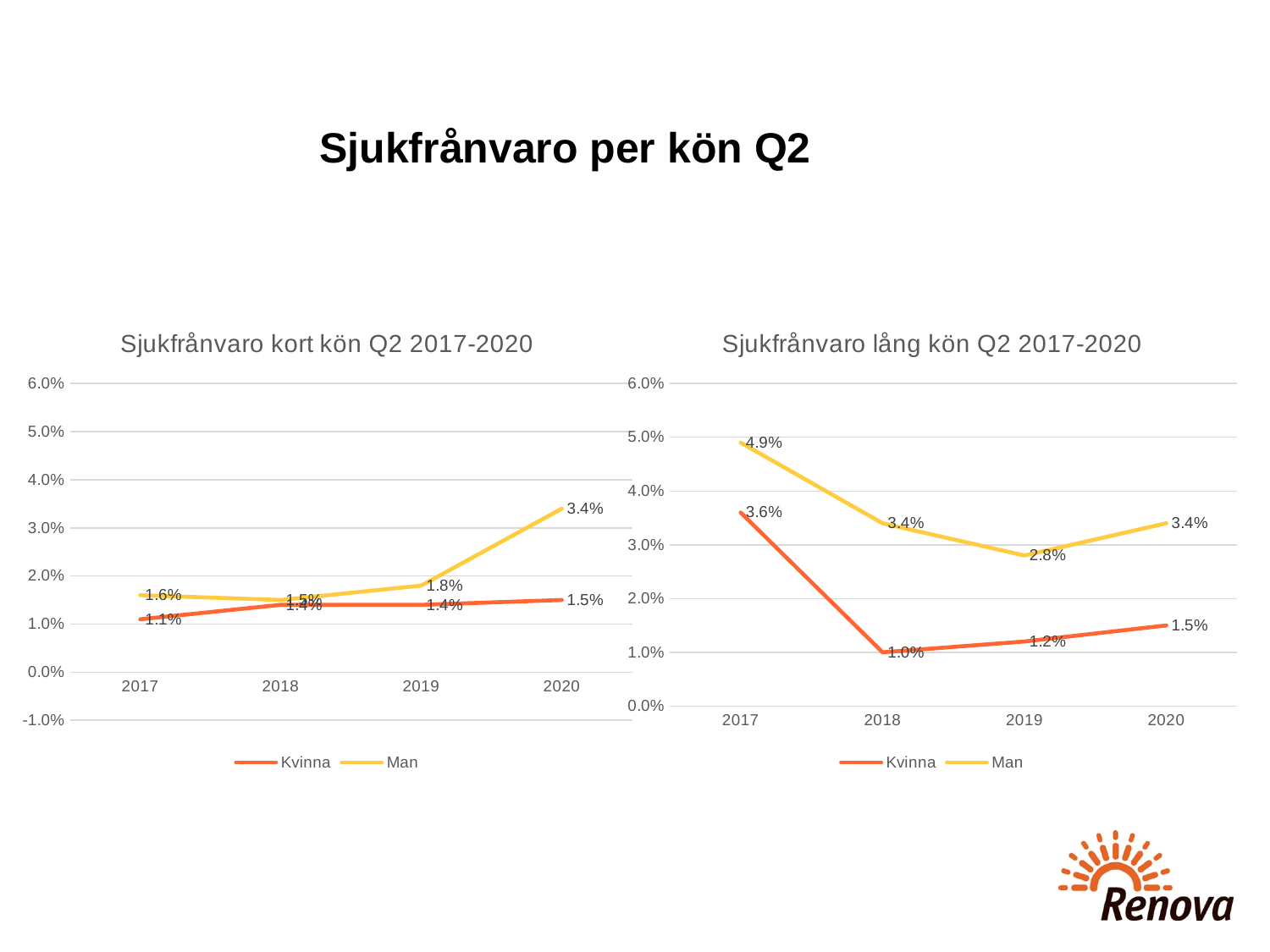
In the chart titled 'Sjukfrånvaro lång kön Q2 2017-2020', what is the value for Kvinna in 2018? 1.0% In the chart titled 'Sjukfrånvaro lång kön Q2 2017-2020', what is the value for Man in 2017? 4.9% In the chart titled 'Sjukfrånvaro lång kön Q2 2017-2020', what is the difference between Man and Kvinna in 2017? 1.3% In the chart titled 'Sjukfrånvaro lång kön Q2 2017-2020', in which year is the Man series lowest? 2019 In the chart titled 'Sjukfrånvaro lång kön Q2 2017-2020', does the Man series rise or fall from 2017 to 2019? Fall In the chart titled 'Sjukfrånvaro lång kön Q2 2017-2020', in which year is the Kvinna series highest? 2017 What kind of chart is the chart titled 'Sjukfrånvaro kort kön Q2 2017-2020'? Line chart In the chart titled 'Sjukfrånvaro kort kön Q2 2017-2020', what is the value for Man in 2020? 3.4% How many series does the legend list in the chart titled 'Sjukfrånvaro lång kön Q2 2017-2020'? 2 In the chart titled 'Sjukfrånvaro kort kön Q2 2017-2020', which series has the higher value in 2019, Kvinna or Man? Man In the chart titled 'Sjukfrånvaro kort kön Q2 2017-2020', what is the value for Kvinna in 2017? 1.1% In the chart titled 'Sjukfrånvaro kort kön Q2 2017-2020', what is the difference between Man and Kvinna in 2020? 1.9%